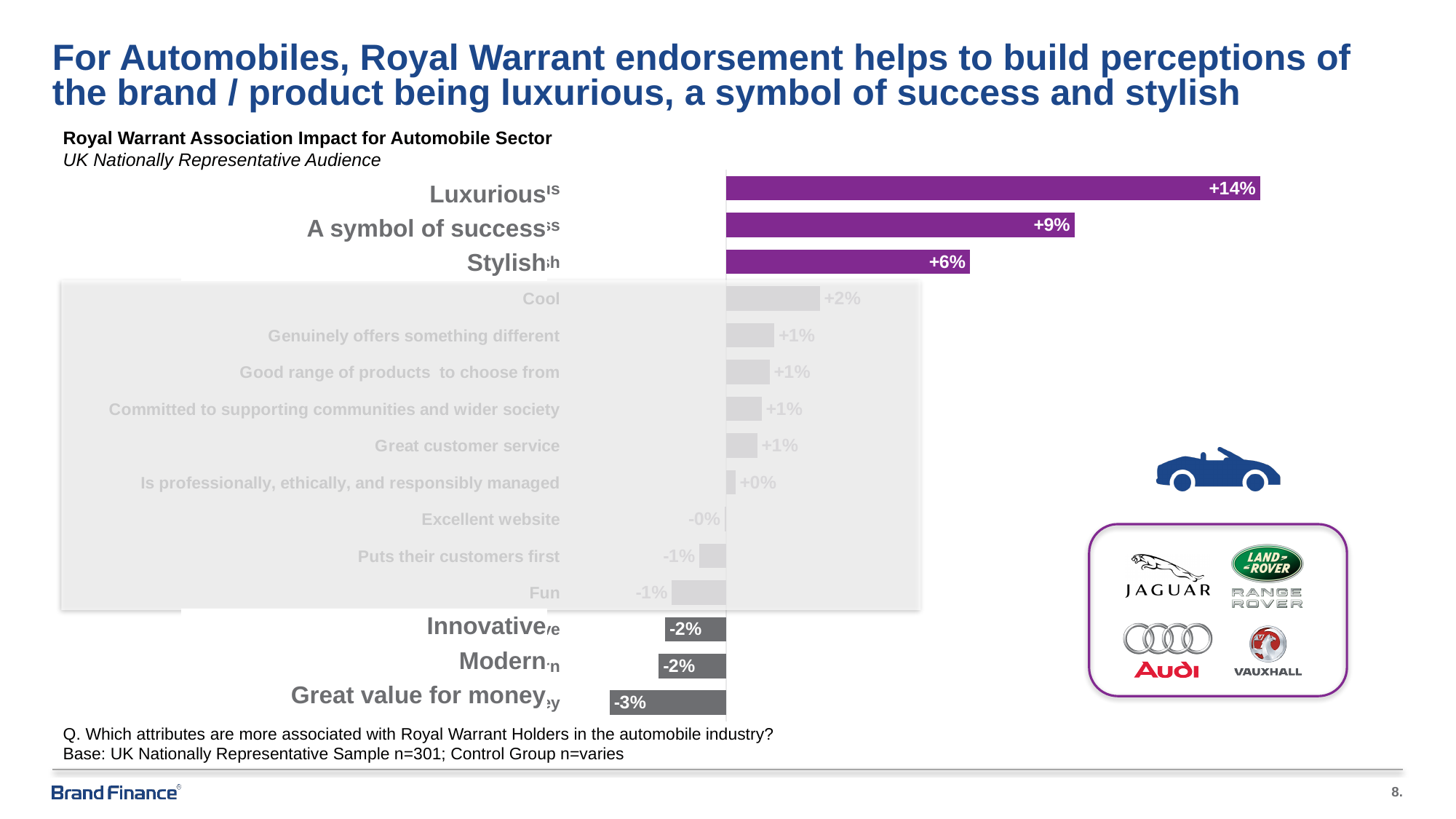
Which attribute has the highest value? Luxurious Which attribute has the lowest value? Great value for money What is the title of the chart? Royal Warrant Association Impact for Automobile Sector What is the value for A symbol of success? +9% What is the value for Great value for money? -3% What is the difference between the values for Luxurious and A symbol of success? 5% What is the value for Cool? +2% What is the value for Luxurious? +14% What kind of chart is shown on the slide? Bar chart What is the value for Stylish? +6% How many attributes are plotted in the chart? 15 Which is larger, the value for Stylish or the value for Cool? Stylish